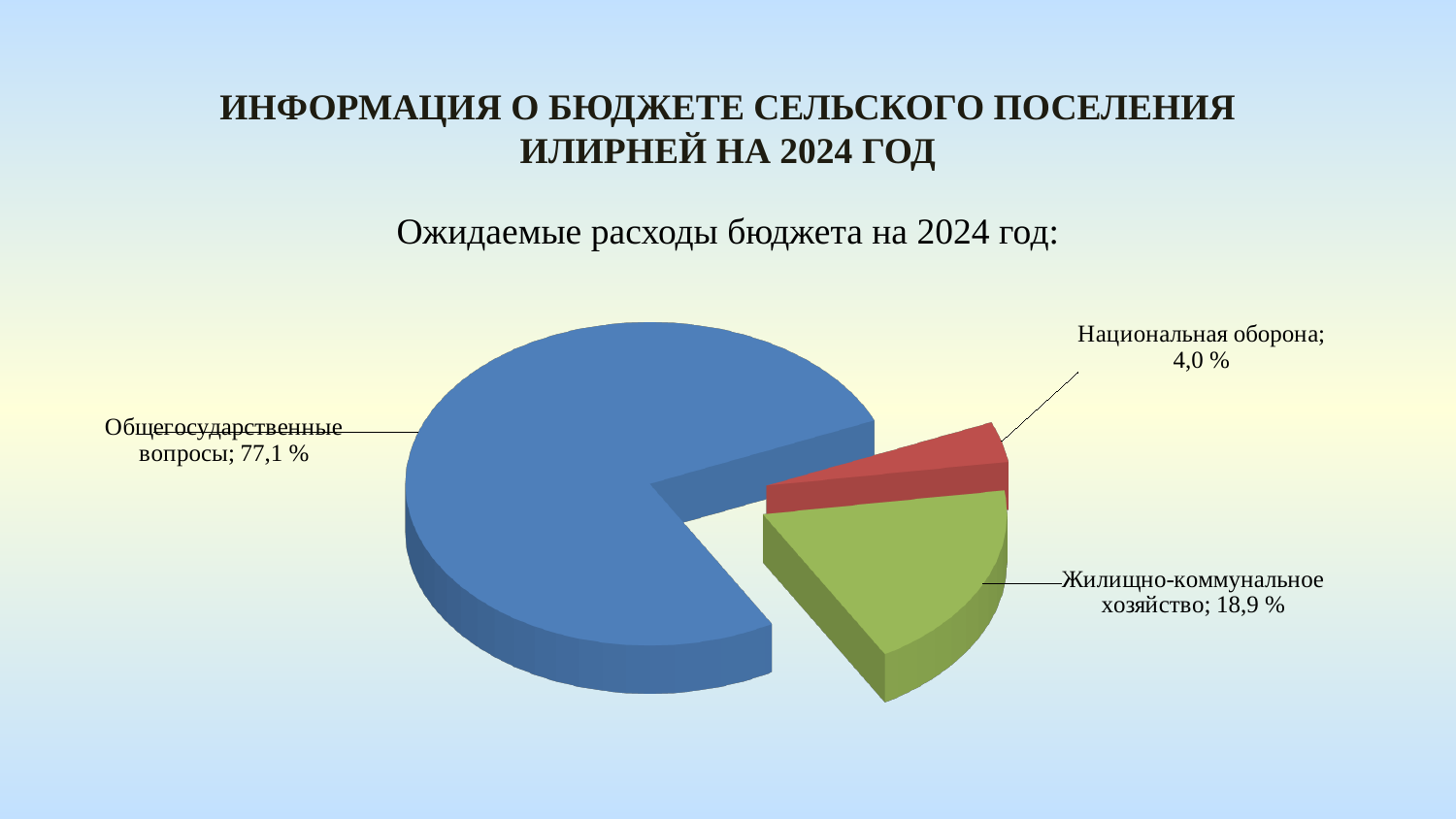
What is the difference in percentage points between Жилищно-коммунальное хозяйство and Национальная оборона? 14,9 What is the difference in percentage points between Общегосударственные вопросы and Жилищно-коммунальное хозяйство? 58,2 How many categories are shown in the pie chart? 3 What colour is the slice for Общегосударственные вопросы? Blue What kind of chart is shown on the slide? Pie chart What share of the pie does Общегосударственные вопросы have? 77,1 % What share of the pie does Жилищно-коммунальное хозяйство have? 18,9 % What is the subtitle above the chart? Ожидаемые расходы бюджета на 2024 год: Which category has the largest share of the pie? Общегосударственные вопросы What share of the pie does Национальная оборона have? 4,0 % Which category has the smallest share of the pie? Национальная оборона Which is larger: the share for Жилищно-коммунальное хозяйство or the share for Национальная оборона? Жилищно-коммунальное хозяйство